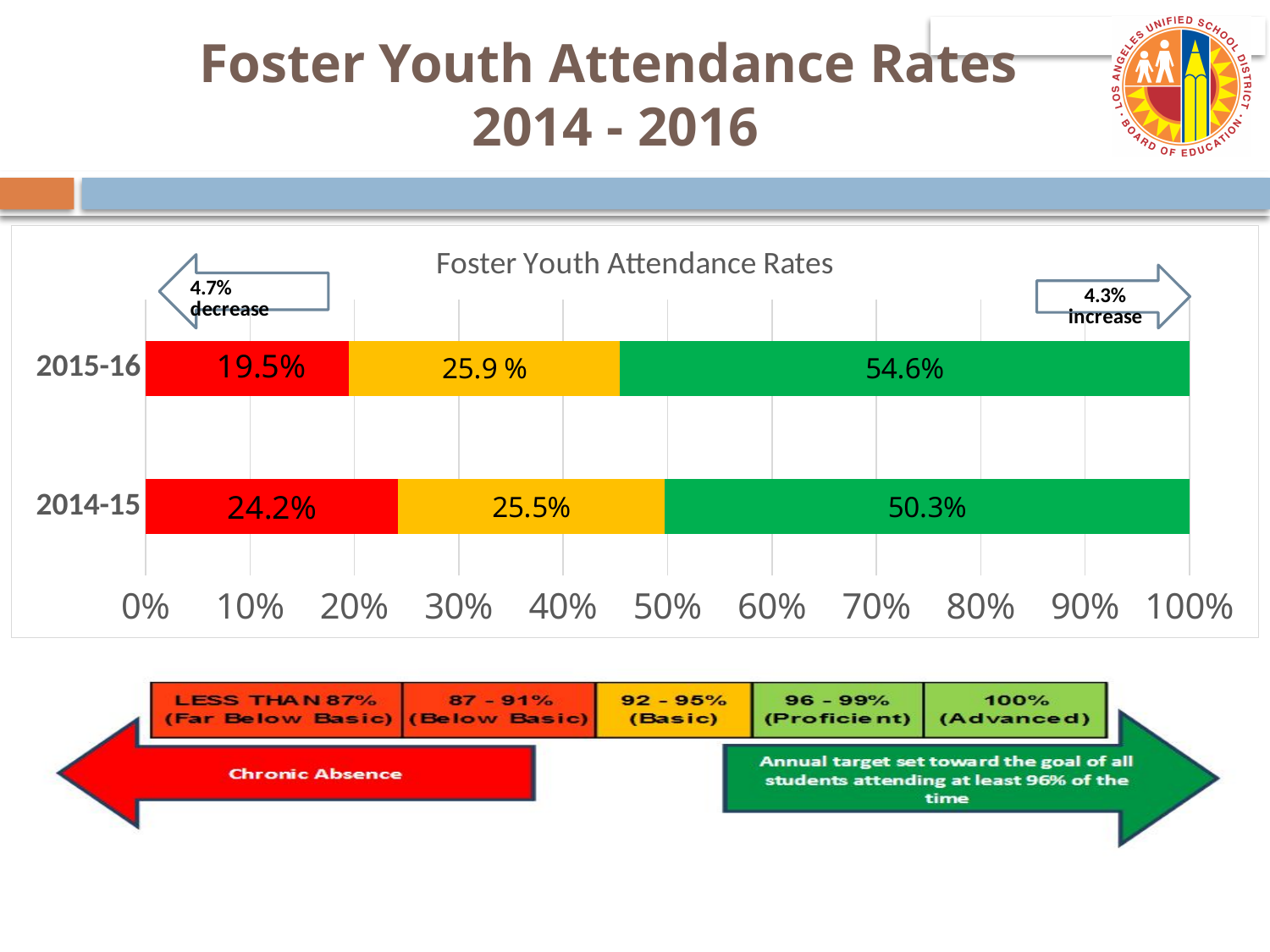
What is the title of the chart? Foster Youth Attendance Rates What type of chart is shown on the slide? stacked bar chart What is the difference between the green segment values for 2015-16 and 2014-15? 4.3% Which year has the larger green segment, 2015-16 or 2014-15? 2015-16 How many years (categories) are shown in the chart? 2 What is the value of the red segment for 2015-16? 19.5% Which year has the larger red segment, 2015-16 or 2014-15? 2014-15 What is the value of the yellow segment for 2015-16? 25.9 % What is the value of the red segment for 2014-15? 24.2% What is the value of the green segment for 2014-15? 50.3% What is the total of the stacked bar for 2014-15? 100% What is the difference between the red segment values for 2014-15 and 2015-16? 4.7%